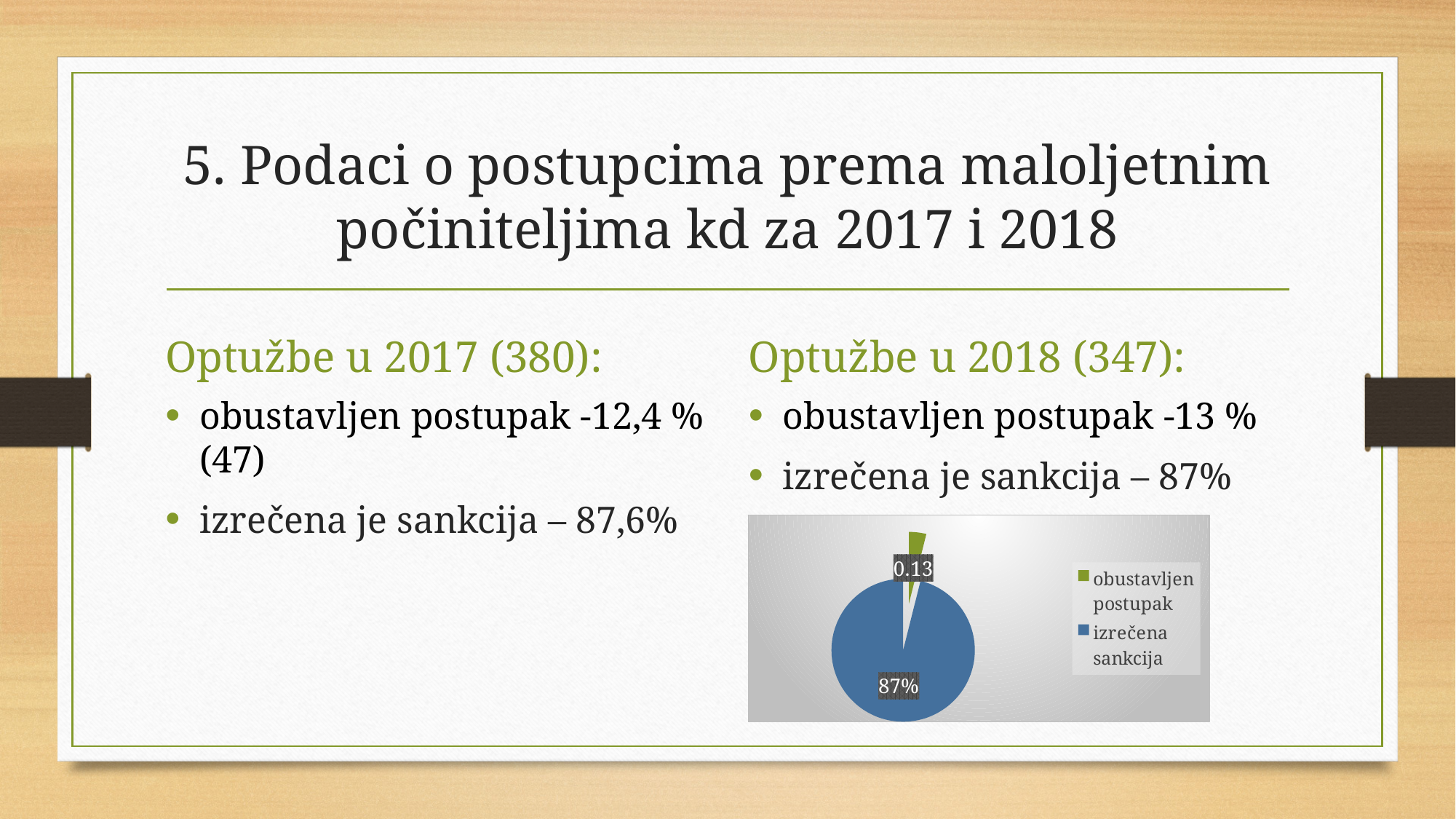
In the pie chart, which is larger: obustavljen postupak or izrečena sankcija? izrečena sankcija Which slice of the pie chart is the largest? izrečena sankcija Which slice of the pie chart is the smallest? obustavljen postupak What share of the pie does izrečena sankcija take, according to its data label? 87% How many slices does the pie chart have? 2 How many entries does the legend of the pie chart list? 2 What value is labelled on the pie chart for izrečena sankcija? 87% What colour is the izrečena sankcija slice in the pie chart? blue What colour is the obustavljen postupak slice in the pie chart? green What value is labelled on the pie chart for obustavljen postupak? 0.13 What kind of chart is shown on the slide? pie chart